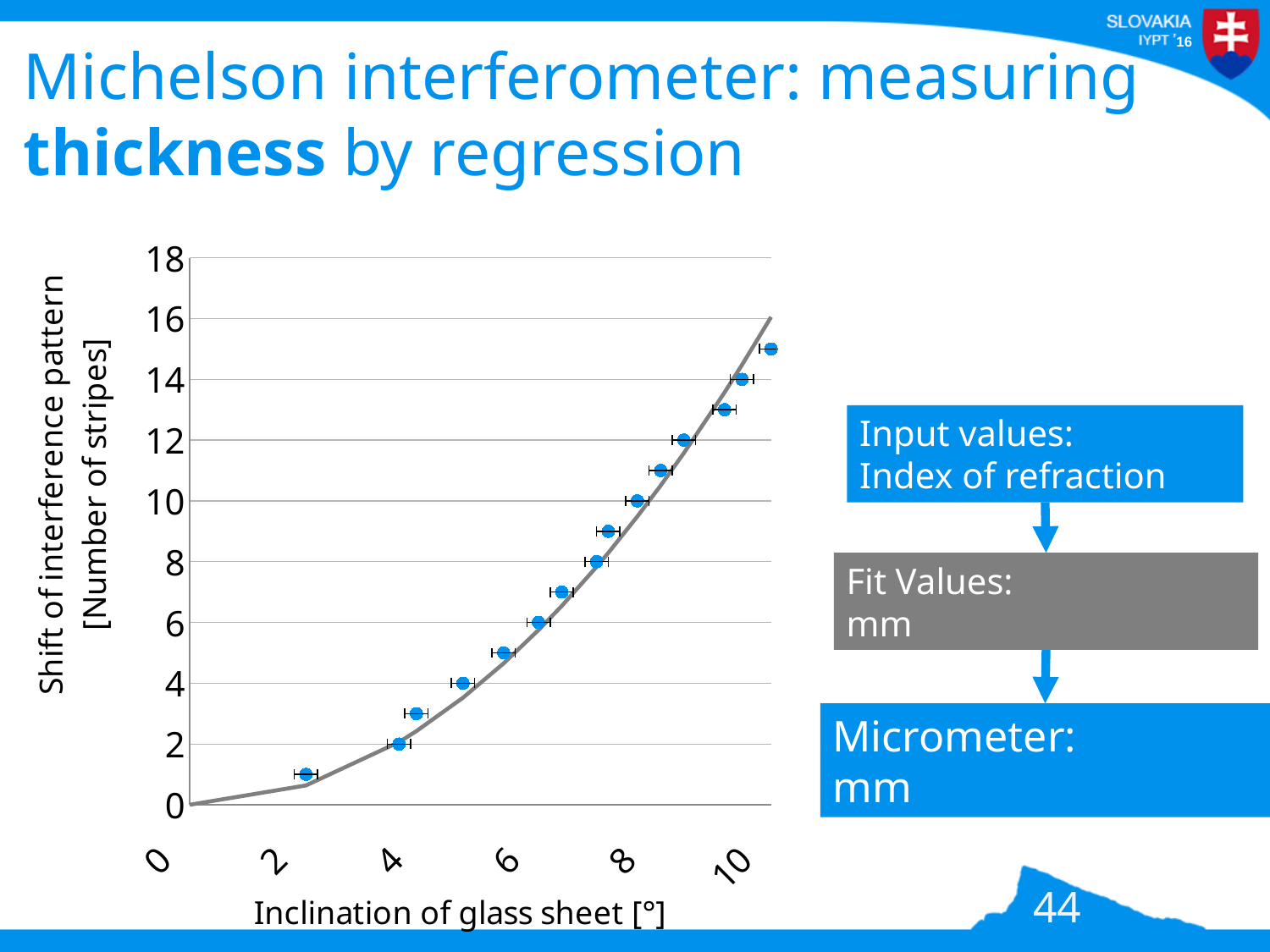
What is the highest tick value shown on the y axis? 18 Which is larger: the shift of the data point nearest 10° or the shift of the data point nearest 2°? the data point nearest 10° What is the highest tick value shown on the x axis? 10 Is the shift value of the lowest data point greater or less than 2? less Do the plotted values rise or fall as the inclination of the glass sheet increases? rise What is the title of the x axis? Inclination of glass sheet [°] What kind of chart is shown on the slide? scatter chart Is the shift value of the highest data point greater or less than 16? less How many data points lie above the 10 gridline on the y axis? 5 Is the shift value of the highest data point greater or less than 14? greater What colour are the plotted data points? blue